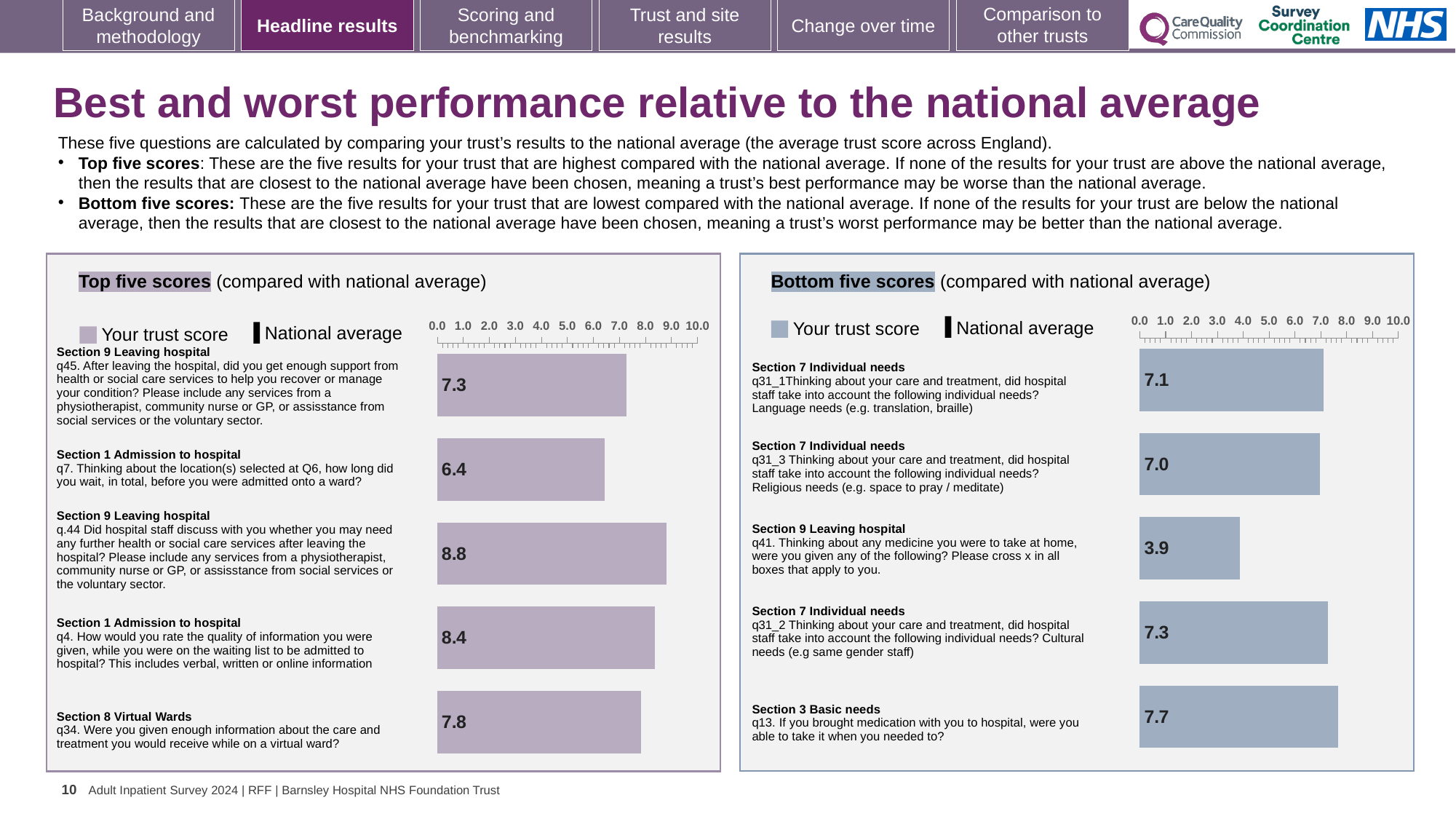
In the Bottom five scores chart, is the value for q31_3 (religious needs) greater or less than 5.0? greater In the Top five scores chart, which has the larger score, q4 or q34? q4 In the Top five scores chart, what is the difference between the scores for q.44 and q7? 2.4 In the Top five scores chart, what is the trust score for q7 (how long did you wait before being admitted onto a ward)? 6.4 In the Bottom five scores chart, what is the trust score for q41 (medicine to take at home)? 3.9 In the Top five scores chart, what is the trust score for q45 (support from health or social care services after leaving hospital)? 7.3 In the Top five scores chart, which question has the highest trust score? q.44 (Section 9 Leaving hospital) In the Bottom five scores chart, which question has the lowest trust score? q41 (Section 9 Leaving hospital) In the Bottom five scores chart, what is the difference between the scores for q13 and q41? 3.8 What type of chart is used in the Top five scores panel? Bar chart How many bars are shown in the Bottom five scores chart? 5 In the Bottom five scores chart, what is the trust score for q13 (able to take medication brought to hospital when needed)? 7.7